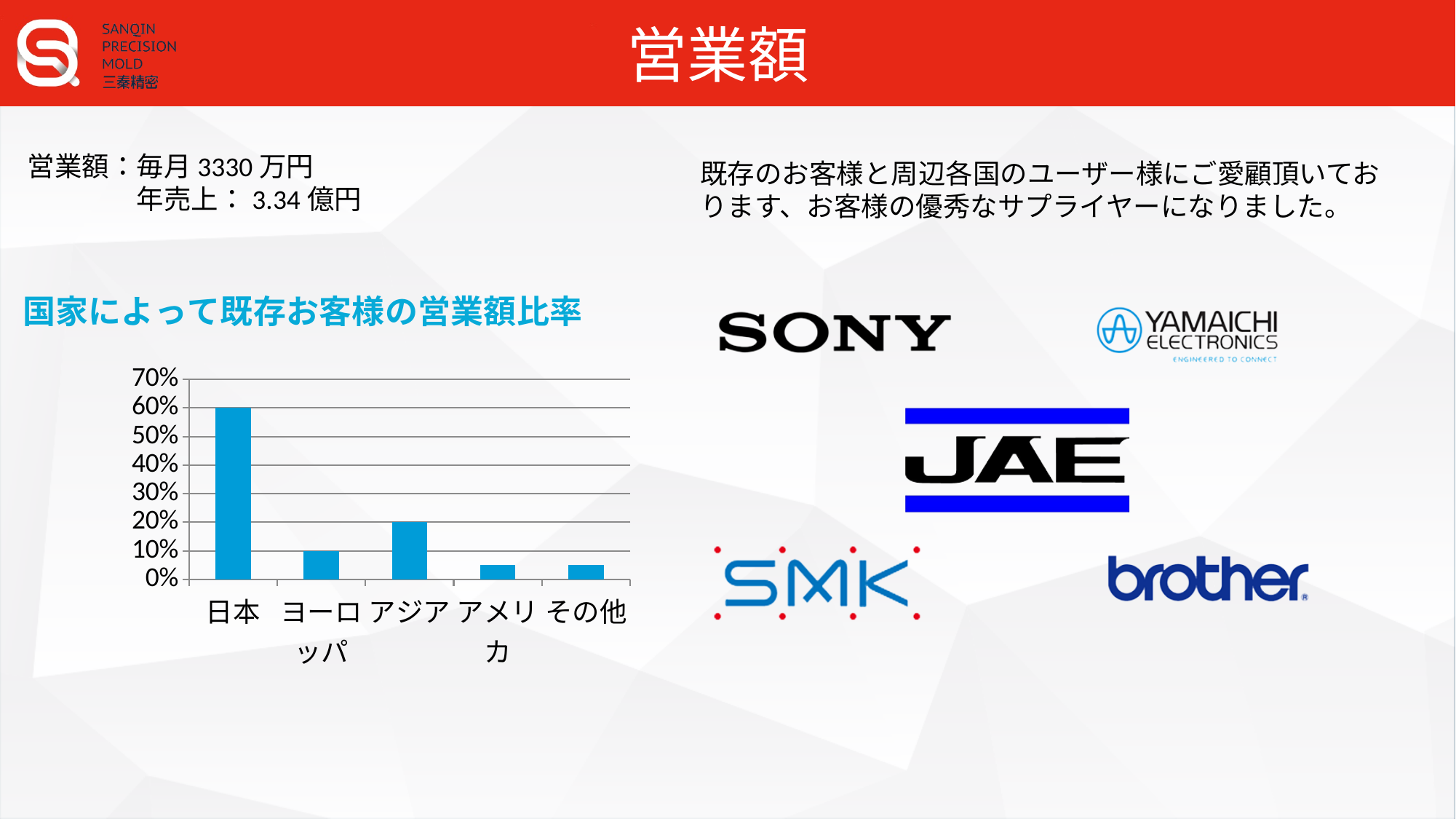
How many categories are shown on the x axis of the chart? 5 Which is larger, the value for アジア or the value for ヨーロッパ? アジア What is the title of the chart? 国家によって既存お客様の営業額比率 What is the value for 日本 in the chart? 60% Is the value for その他 greater or less than 10%? less What is the difference between the values for 日本 and アジア? 40% What type of chart is shown on the slide? bar chart What is the value for ヨーロッパ in the chart? 10% What is the value for アジア in the chart? 20% What is the highest value shown on the y axis of the chart? 70% Is the value for アメリカ greater or less than 10%? less Which category has the highest value in the chart? 日本